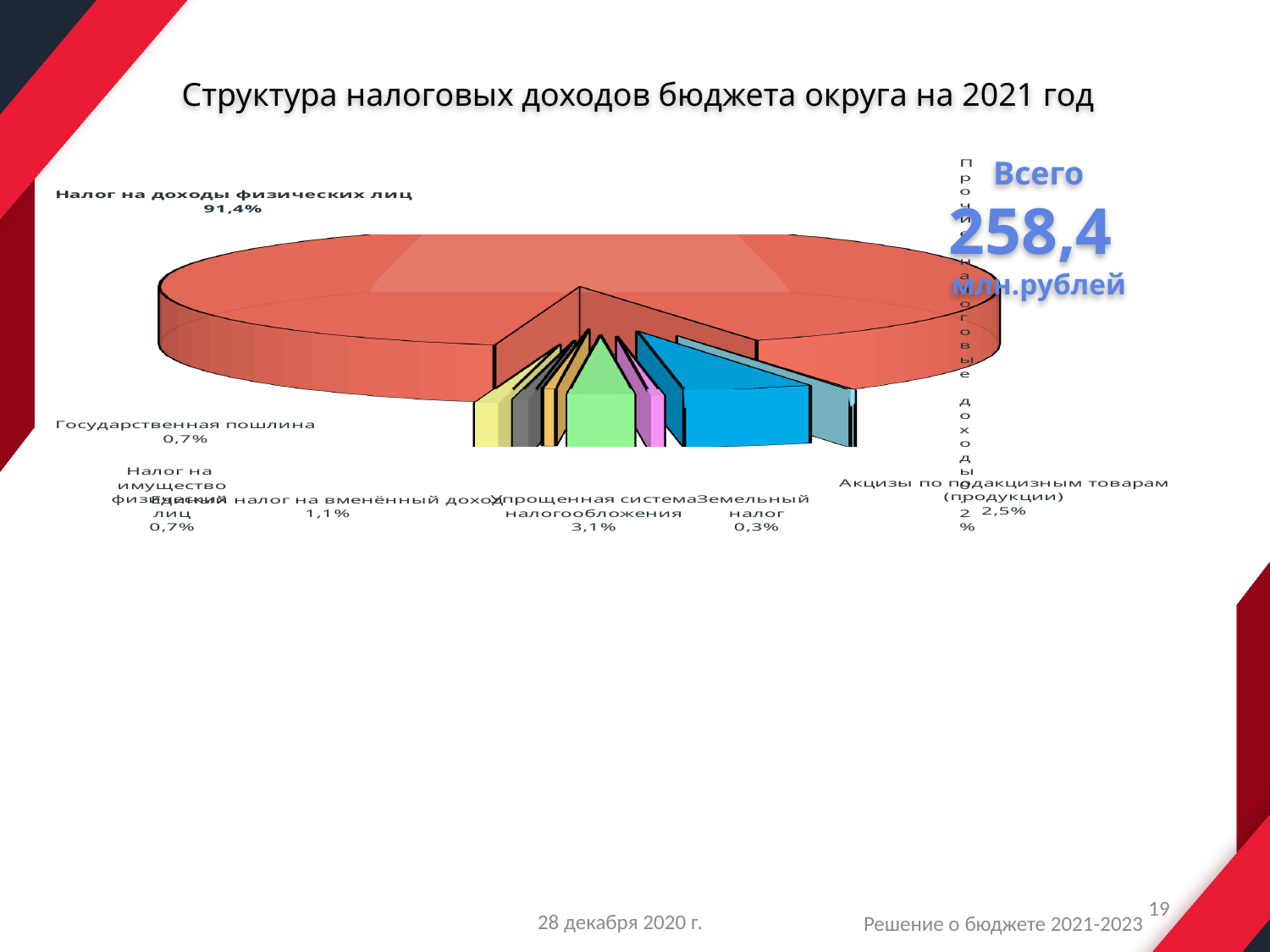
Which is larger: Упрощенная система налогообложения or Акцизы по подакцизным товарам (продукции)? Упрощенная система налогообложения What is the value shown for Единый налог на вменённый доход? 1,1% What is the difference between the shares of Упрощенная система налогообложения and Единый налог на вменённый доход? 2,0% What share of the pie does Налог на доходы физических лиц have? 91,4% What is the value shown for Земельный налог? 0,3% What is the value shown for Государственная пошлина? 0,7% What total amount is stated next to the chart? 258,4 млн.рублей What is the value shown for Акцизы по подакцизным товарам (продукции)? 2,5% What is the value shown for Упрощенная система налогообложения? 3,1% What kind of chart is shown on the slide? Pie chart Which category has the largest share of the pie? Налог на доходы физических лиц